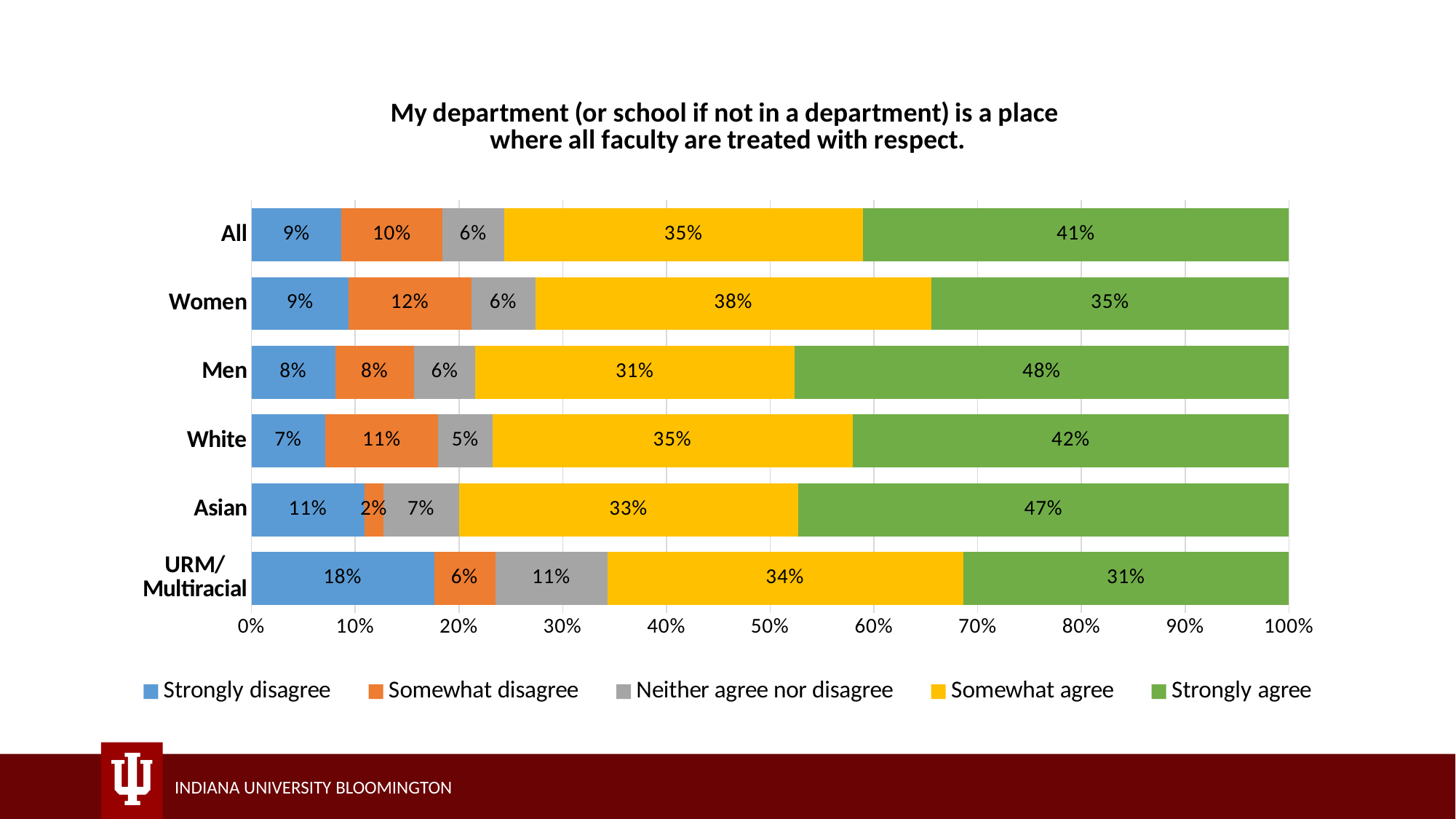
Which colour represents Neither agree nor disagree in the chart? Gray Which is larger: the Somewhat disagree percentage for Women or for Asian faculty? Women Which group has the lowest percentage for Strongly agree? URM/Multiracial What kind of chart is shown on the slide? Stacked bar chart What is the combined percentage of Somewhat agree and Strongly agree for the All group? 76% How many groups (categories) are shown on the chart? 6 How many response categories does the legend list? 5 What percentage of Men strongly agree that their department is a place where all faculty are treated with respect? 48% What is the difference between the Strongly agree percentages for Men and Women? 13% What percentage of Women somewhat agree? 38% What percentage of URM/Multiracial faculty strongly disagree? 18% Which group has the highest percentage for Strongly agree? Men